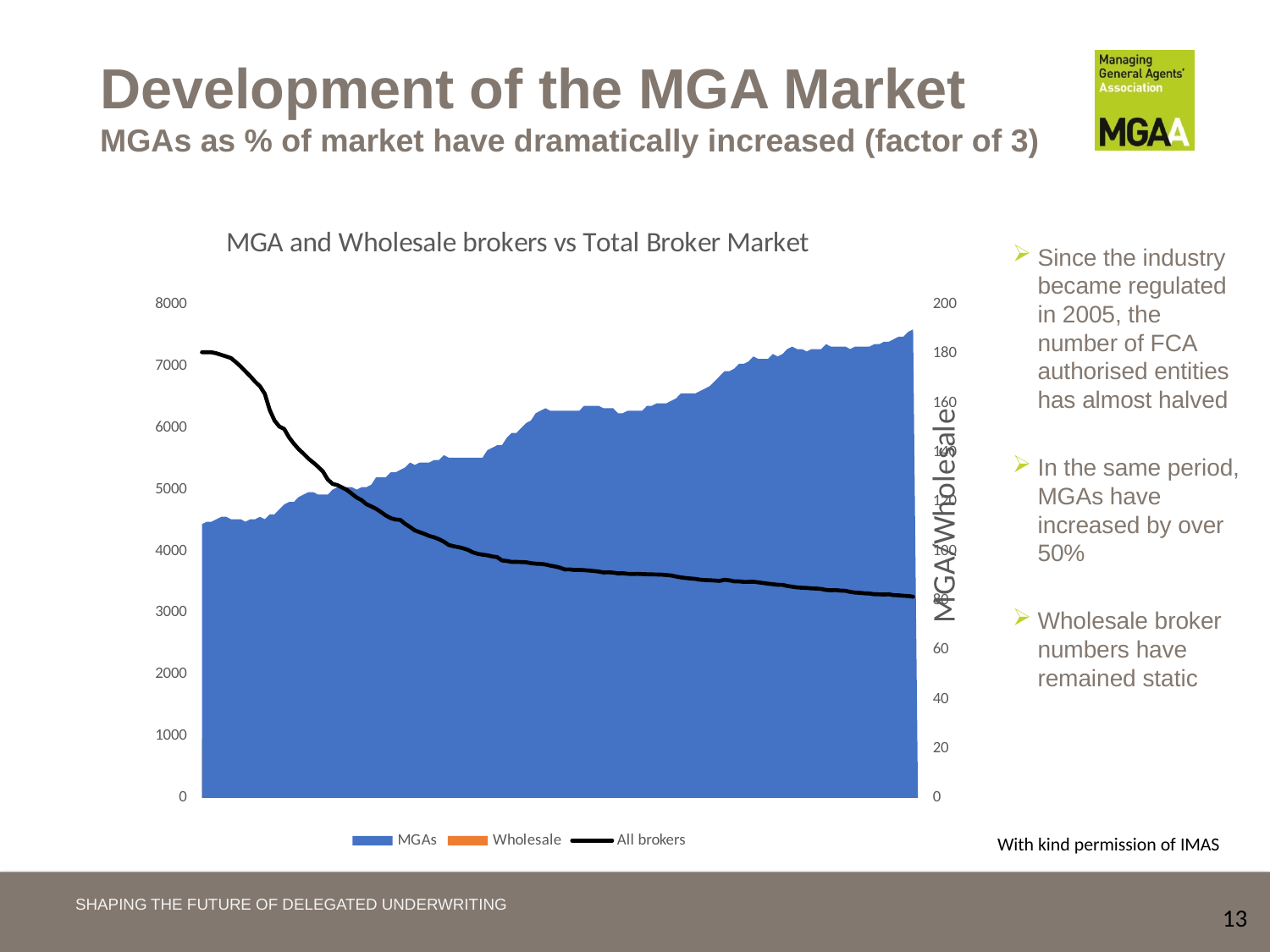
Does the All brokers line rise or fall from left to right along the x axis? Fall What is the title of the chart? MGA and Wholesale brokers vs Total Broker Market Is the All brokers line higher at the left end or the right end of the chart? Left end What kind of chart is shown on the slide? Area chart with a line series Does the MGAs area rise or fall from left to right along the x axis? Rise How many series does the chart legend list? 3 At the right end of the chart, is the MGAs value greater or less than 160 on the right axis? greater At the left end of the chart, is the MGAs value greater or less than 140 on the right axis? less What is the maximum value shown on the left vertical axis? 8000 At the right end of the chart, is the All brokers value greater or less than 4000 on the left axis? less What are the series names listed in the chart legend? MGAs, Wholesale, All brokers